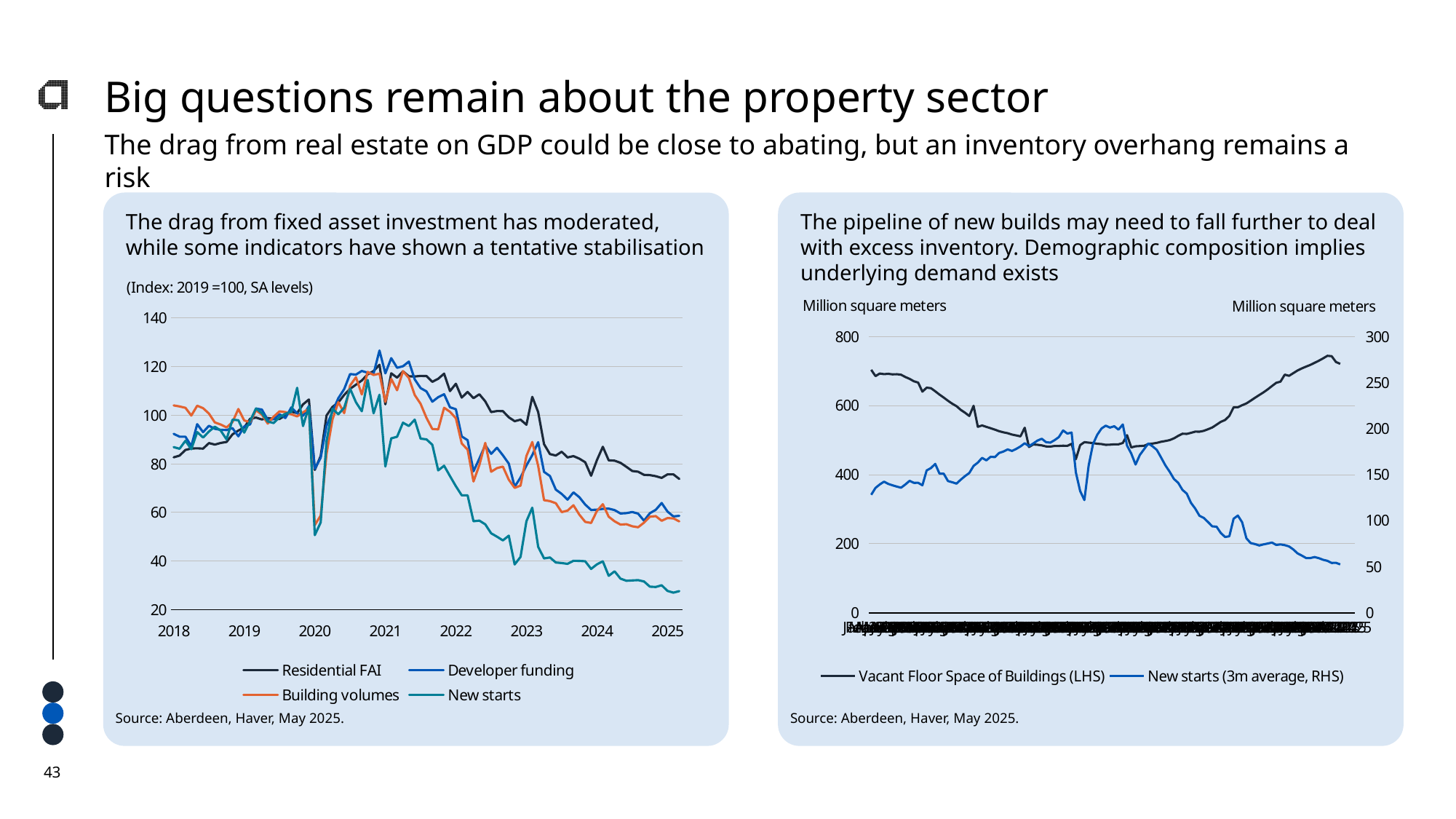
In the left chart, is the value of New starts at the end of the series in 2025 greater or less than 40? less In the right chart, is the latest value of New starts (3m average, RHS) greater or less than 100? less What kind of chart is the left chart (Index: 2019 =100, SA levels)? line chart In the left chart, does the New starts series rise or fall between 2021 and 2025? fall In the left chart, is the lowest value of New starts during 2020 greater or less than 60? less In the right chart, does the Vacant Floor Space of Buildings series rise or fall between 2022 and 2025? rise How many series does the legend of the right chart list? 2 How many series does the legend of the left chart list? 4 In the left chart, which series is lowest at the end of 2025? New starts What unit is shown on both vertical axes of the right chart? Million square meters